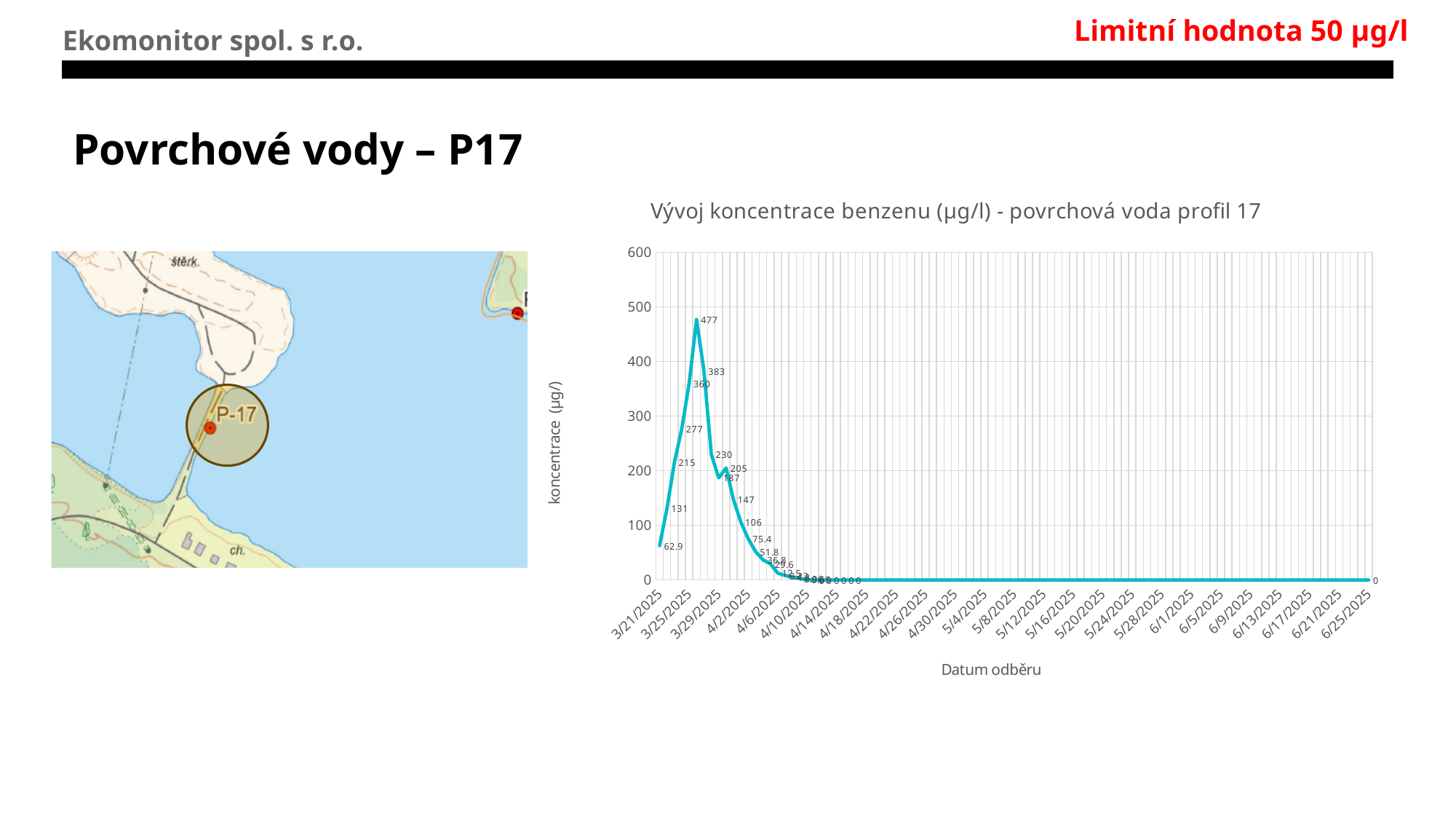
What is the benzene concentration value at the last point, 6/25/2025? 0 Which is larger, the labelled value 360 or the labelled value 383? 383 What is the difference between the labelled values 106 and 75.4? 30.6 What is the difference between the peak value 477 and the next labelled value 383? 94 What is the label of the x axis of the chart? Datum odběru What is the difference between the labelled values 215 and 131? 84 What is the title of the chart? Vývoj koncentrace benzenu (µg/l) - povrchová voda profil 17 Is the value for 4/22/2025 greater or less than 100? less What is the benzene concentration value at the first point, 3/21/2025? 62.9 After reaching the peak of 477, do the values rise or fall along the x axis? fall What is the highest benzene concentration value labelled on the chart? 477 What kind of chart is shown on the slide? line chart